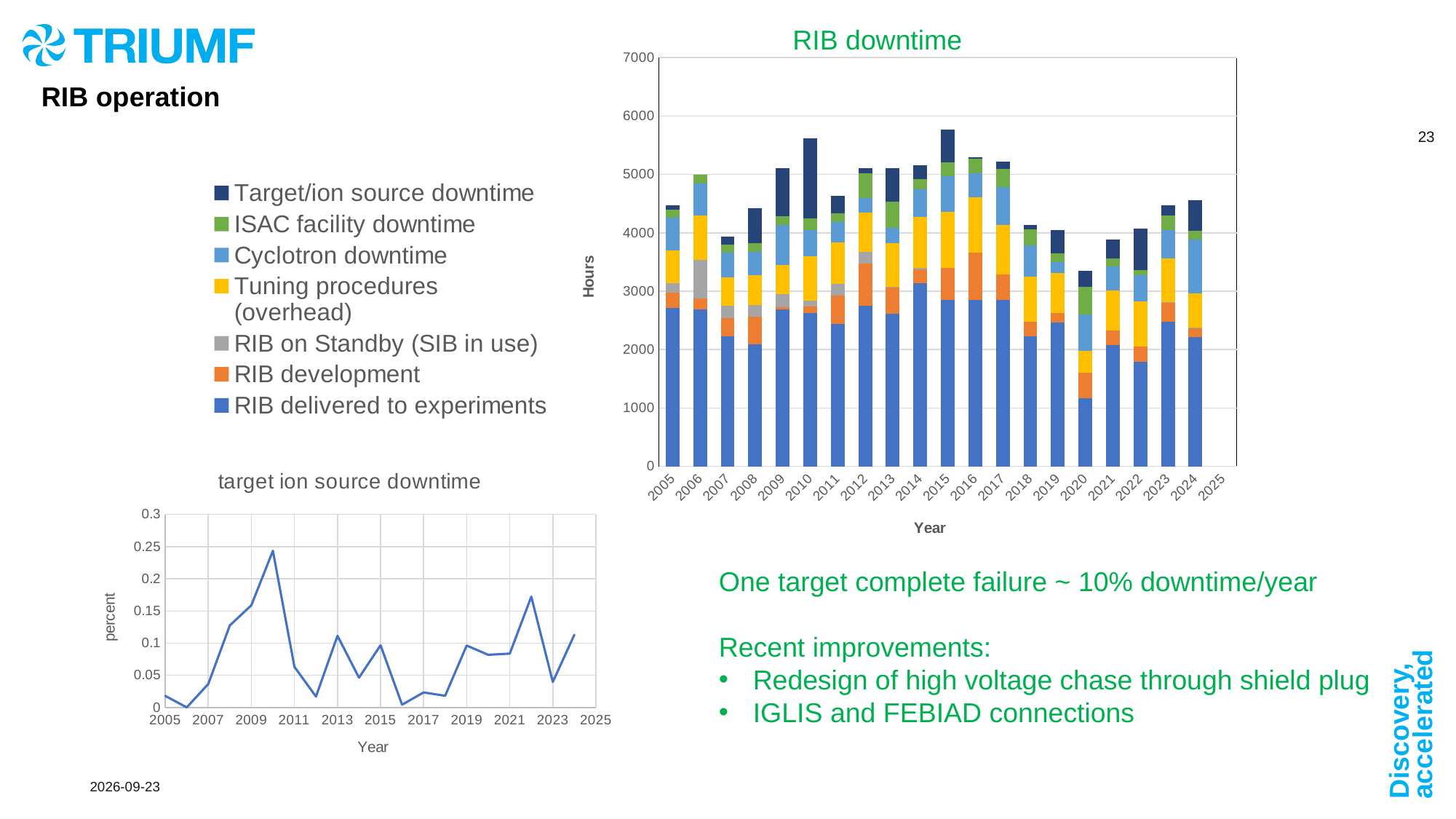
In the 'RIB downtime' chart, is the total height of the 2020 bar greater or less than 4000? less In the 'target ion source downtime' chart, which year has the highest value? 2010 What kind of chart is the 'RIB downtime' chart? bar chart In the 'target ion source downtime' chart, is the value for 2010 greater or less than 0.2? greater How many series does the legend of the 'RIB downtime' chart list? 7 What kind of chart is the 'target ion source downtime' chart? line chart In the 'RIB downtime' chart, which year has the tallest stacked bar? 2015 In the 'RIB downtime' chart, is the total height of the 2010 bar greater or less than 5000? greater In the 'RIB downtime' chart, which bar is taller in total, 2010 or 2011? 2010 In the 'RIB downtime' chart, which year has the shortest stacked bar? 2020 What is the label on the vertical axis of the 'RIB downtime' chart? Hours